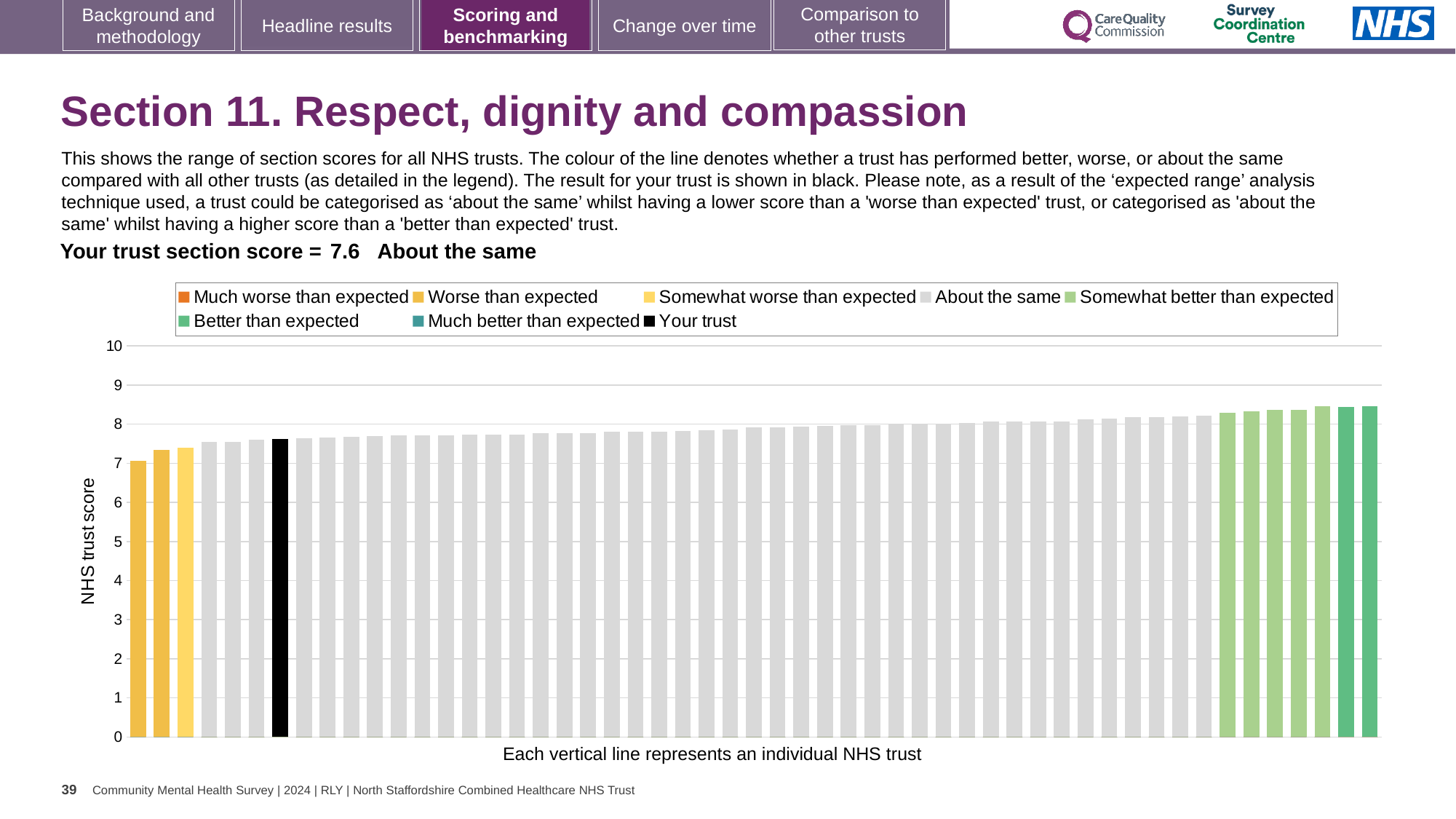
What type of chart is shown on the slide? bar chart How is your trust's score categorised compared with other trusts? About the same What is the section score for your trust, as printed on the slide? 7.6 How many entries does the chart legend list? 8 Is the value of the tallest bar greater or less than 8? greater Which is larger: the value of the rightmost bar or the value of the leftmost bar? the rightmost bar What is the label of the y axis? NHS trust score Is the value of the black bar (your trust) greater or less than 7? greater Is the value of the tallest bar greater or less than 9? less What colour is used for the bar representing your trust? black Do the bar values rise or fall from left to right along the x axis? rise